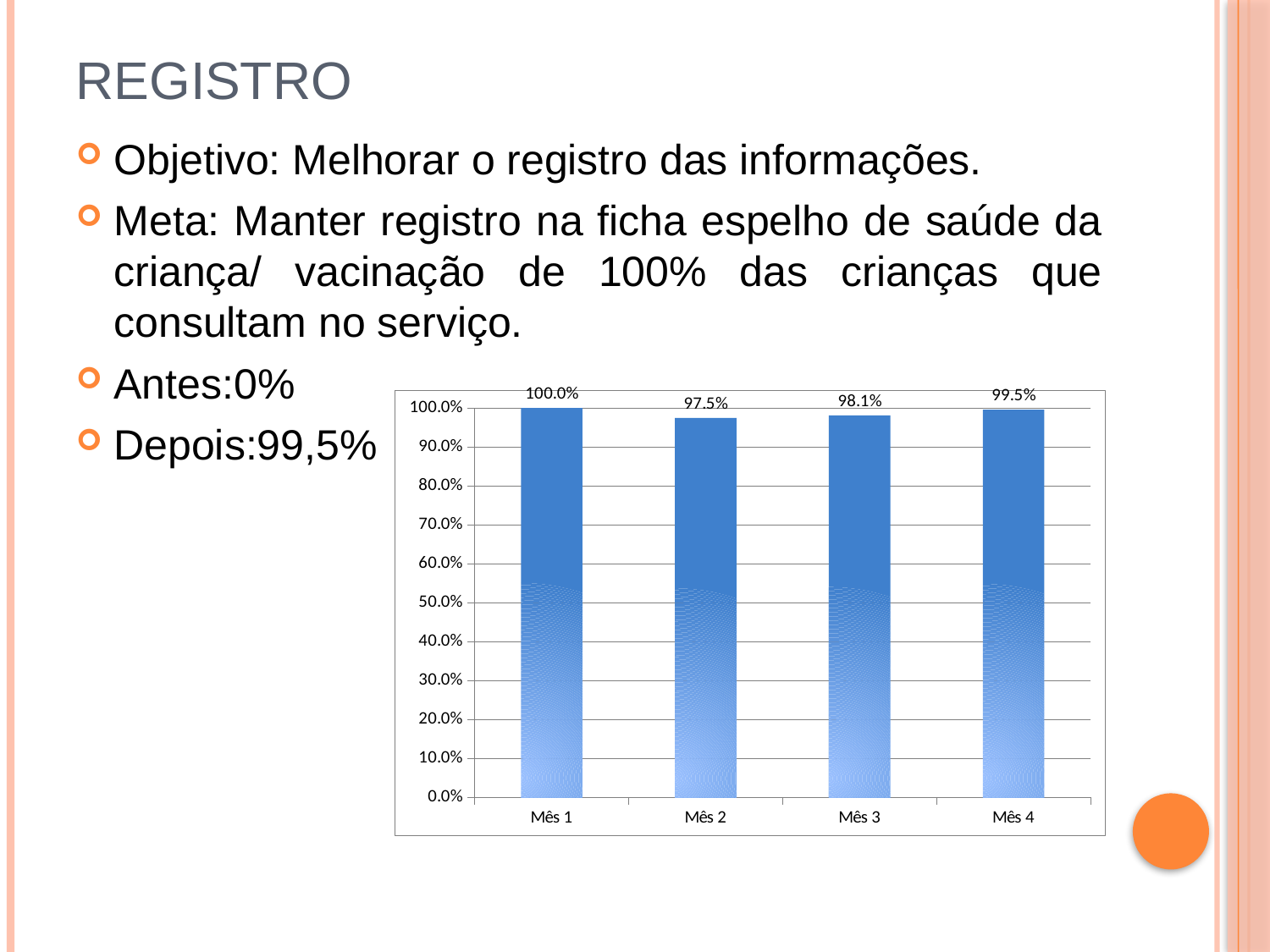
What colour are the bars in the chart? blue What kind of chart is shown on the slide? bar chart Which is larger, the value for Mês 3 or the value for Mês 4? Mês 4 Is the value for Mês 2 greater or less than 90.0%? greater What is the value for Mês 1? 100.0% What is the value for Mês 2? 97.5% Which month has the highest value? Mês 1 What is the value for Mês 3? 98.1% How many months are shown on the x axis? 4 What is the difference between the values for Mês 1 and Mês 2? 2.5% Which month has the lowest value? Mês 2 What is the value for Mês 4? 99.5%